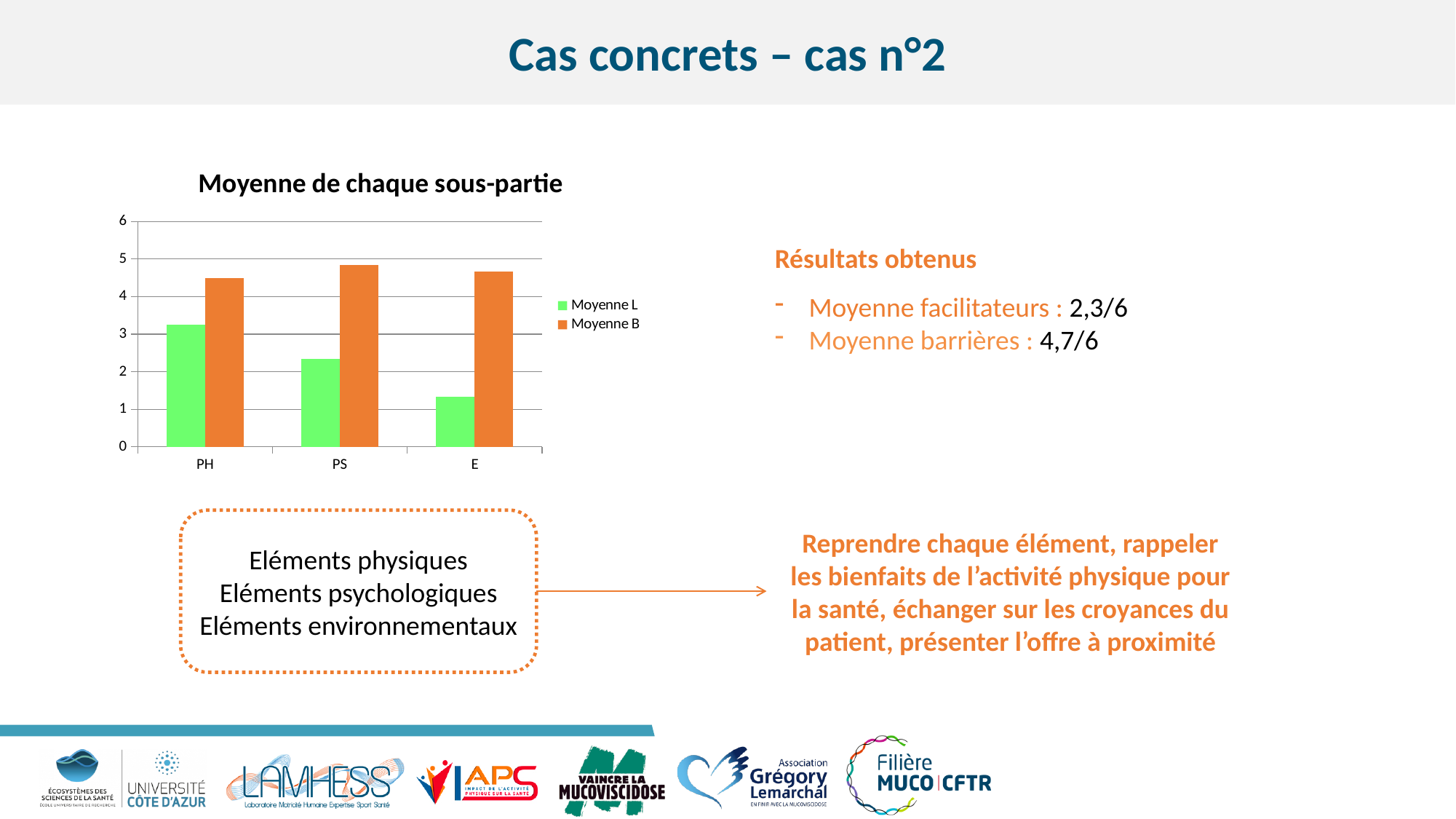
Which series is shown in orange in the chart? Moyenne B Is the value for Moyenne L in category E greater or less than 2? less Do the Moyenne L values rise or fall from PH to E along the x axis? fall Is the value for Moyenne L in category PH greater or less than 3? greater How many series does the chart legend list? 2 How many categories are shown on the x axis of the chart? 3 Which category has the highest value for Moyenne L? PH What kind of chart is shown on the slide? bar chart Which category has the lowest value for Moyenne L? E For category E, which series has the larger value, Moyenne L or Moyenne B? Moyenne B What is the title of the chart? Moyenne de chaque sous-partie Is the value for Moyenne B in category PS greater or less than 4? greater